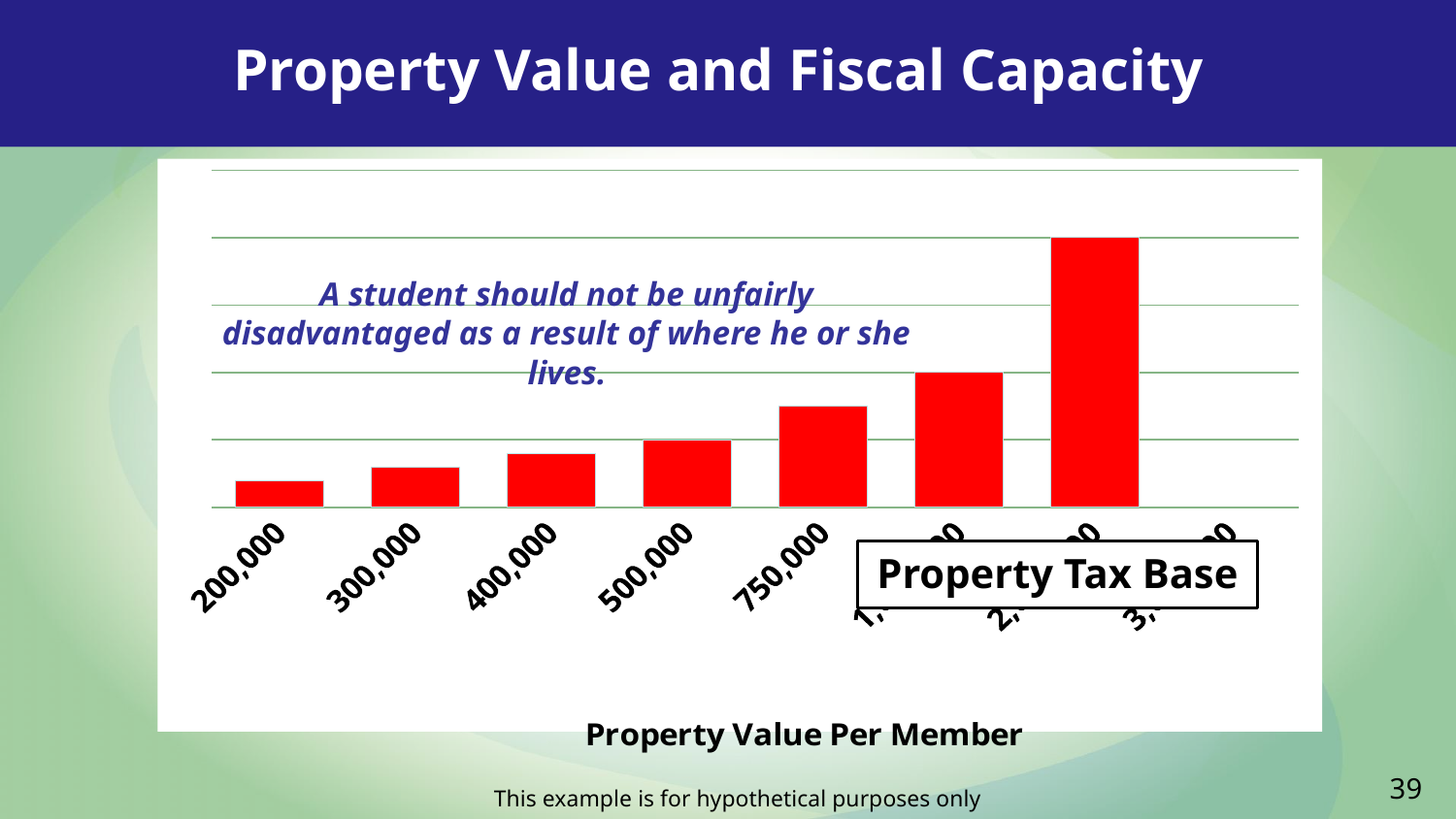
Which property value category has the lowest bar? 200,000 What colour are the bars in the chart? red What is the title of the x axis? Property Value Per Member Do the bar heights rise or fall as property value per member increases along the x axis? rise Which bar is taller, 750,000 or 500,000? 750,000 What kind of chart is shown on the slide? bar chart How many bars are plotted in the chart? 7 Which bar is taller, 300,000 or 400,000? 400,000 Which bar is taller, 200,000 or 750,000? 750,000